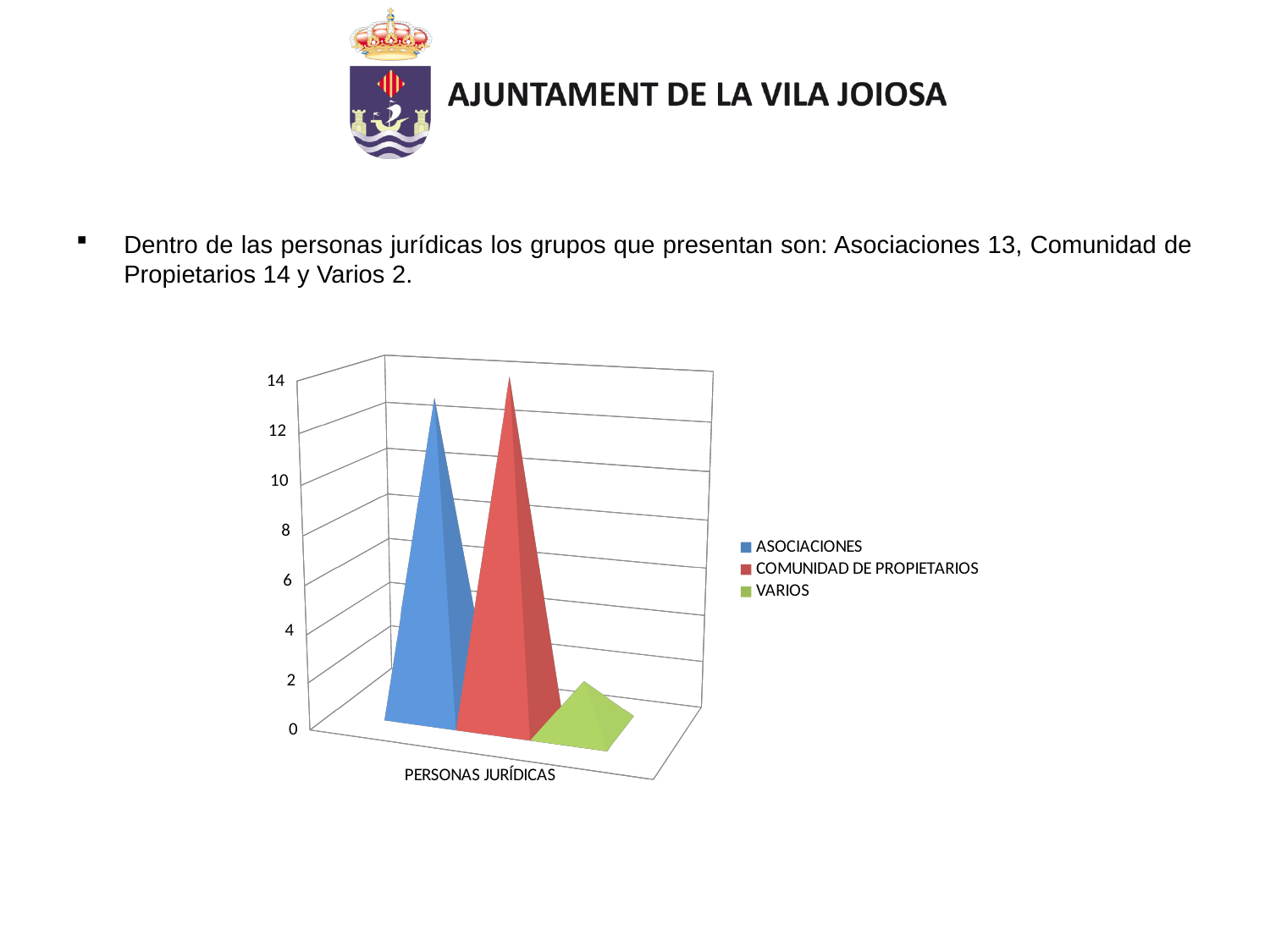
What is the value for VARIOS in the chart? 2 What is the value for ASOCIACIONES in the chart? 13 What is the difference between the value for COMUNIDAD DE PROPIETARIOS and the value for VARIOS? 12 Which is larger, the value for ASOCIACIONES or the value for VARIOS? ASOCIACIONES What is the category label shown on the x axis of the chart? PERSONAS JURÍDICAS Which colour represents COMUNIDAD DE PROPIETARIOS in the chart legend? Red How many series does the chart legend list? 3 Is the value for VARIOS greater or less than 4? less Which series has the lowest value in the chart? VARIOS Is the value for ASOCIACIONES greater or less than 10? greater How many categories are shown on the x axis of the chart? 1 What is the value for COMUNIDAD DE PROPIETARIOS in the chart? 14